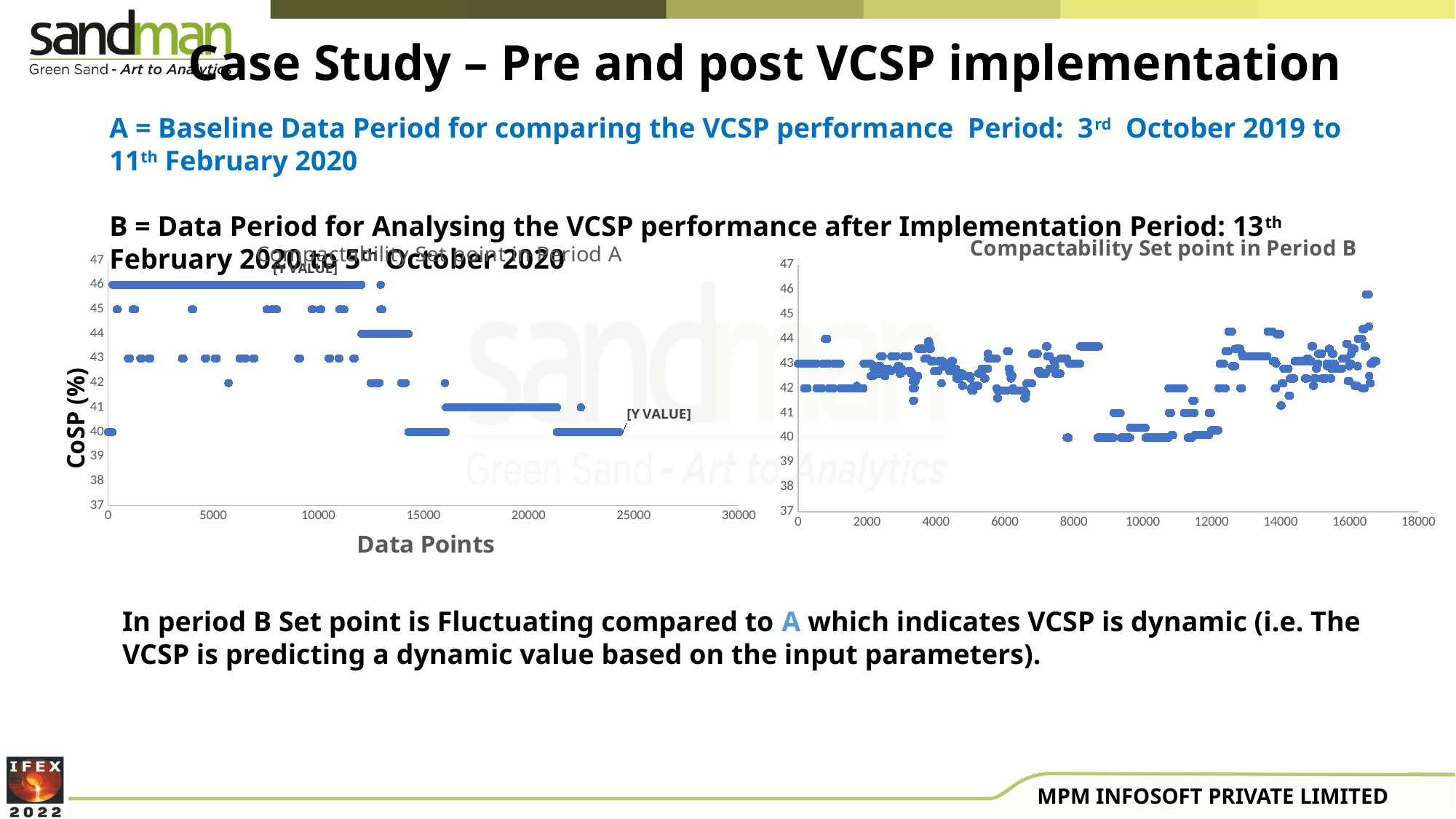
In the 'Compactability Set point in Period A' chart, what is the title of the horizontal axis? Data Points What is the highest value shown on the vertical axis of the 'Compactability Set point in Period B' chart? 47 In the 'Compactability Set point in Period B' chart, is the highest plotted value, near data point 16500, greater or less than 45? greater In the 'Compactability Set point in Period A' chart, what is the title of the vertical axis? CoSP (%) In the 'Compactability Set point in Period A' chart, do the set point values generally rise or fall as the data points increase along the x axis? fall What kind of chart is the 'Compactability Set point in Period A' chart? scatter chart What kind of chart is the 'Compactability Set point in Period B' chart? scatter chart